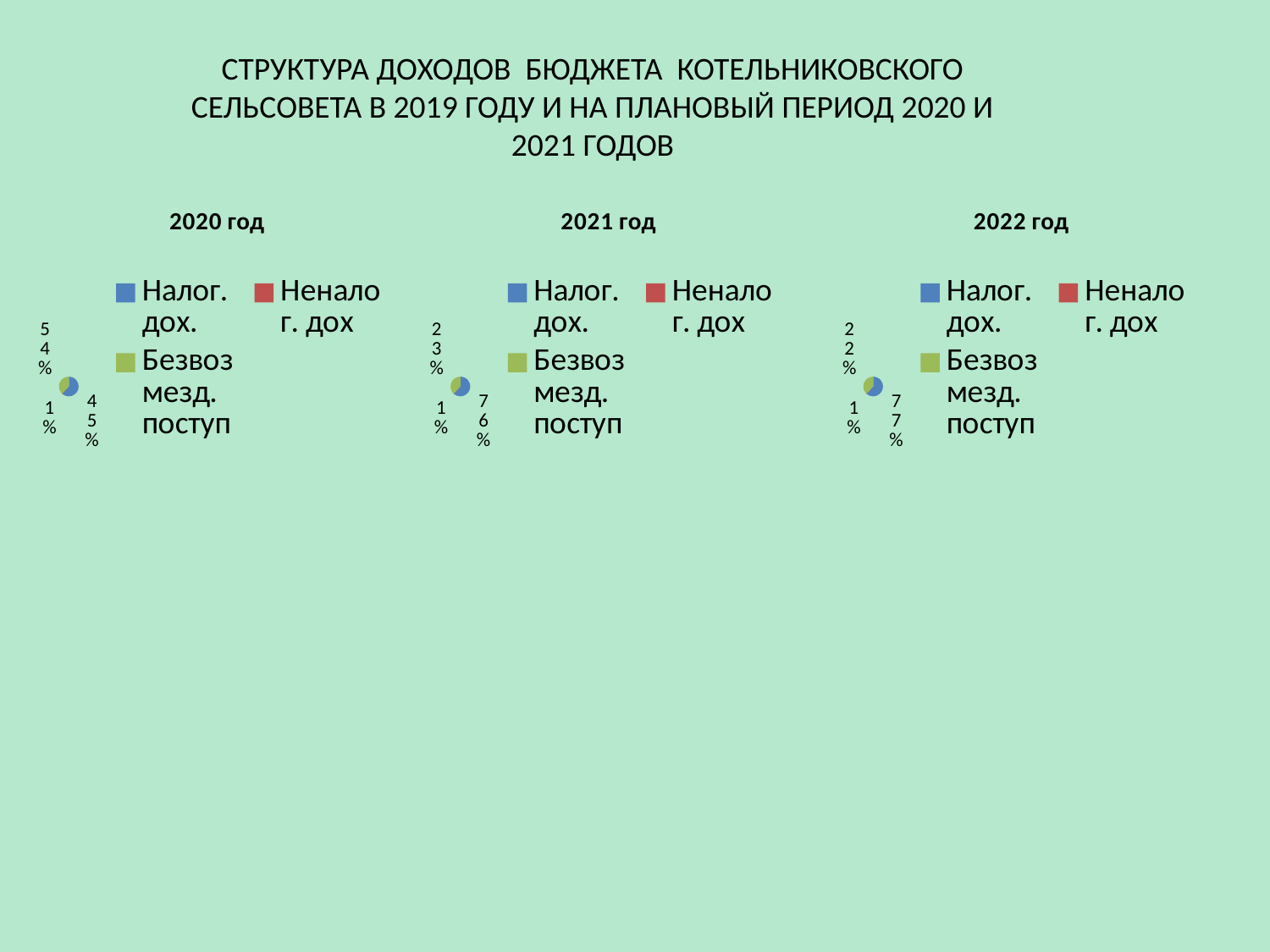
Which legend entry in the "2020 год" chart is shown in green? Безвозмезд. поступ In the "2021 год" chart, what is the largest percentage label shown? 76% How many charts are shown on the slide? 3 In the "2022 год" chart, what is the largest percentage label shown? 77% In the "2020 год" chart, what is the largest percentage label shown? 54% How many series does the legend of the "2021 год" chart list? 3 In the "2022 год" chart, what is the smallest percentage label shown? 1% Is the largest slice in the "2021 год" chart larger or smaller than the largest slice in the "2020 год" chart? larger What colour is the "Налог. дох." series in the legend of the "2022 год" chart? blue Which chart on the slide shows a slice labelled 23%? 2021 год What kind of chart is used for the "2020 год" chart? pie chart Which chart on the slide shows a slice labelled 45%? 2020 год